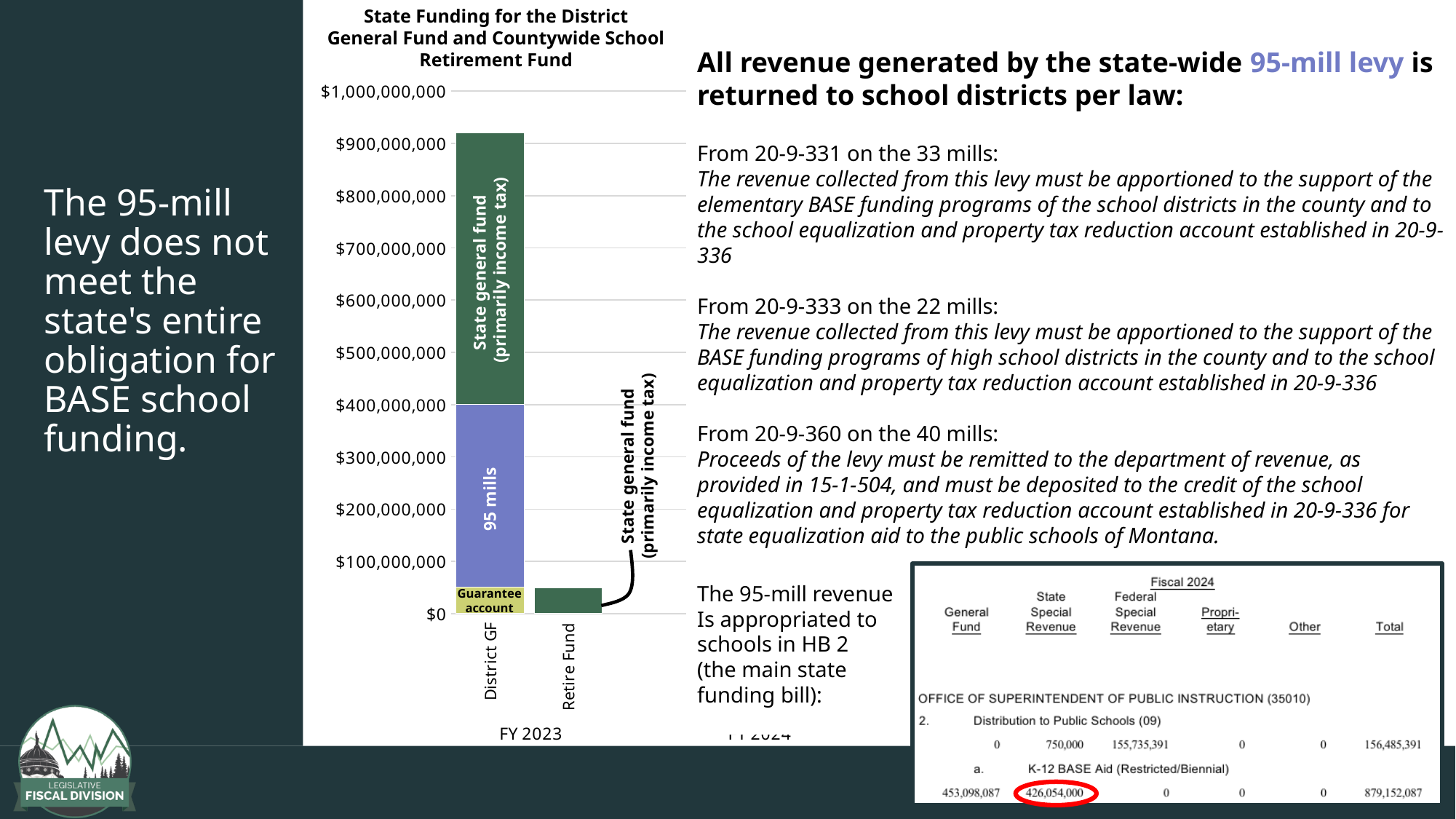
Is the Guarantee account segment in the District GF bar greater or less than $100,000,000? less Which category has the lowest total bar in the chart? Retire Fund What kind of chart is shown on the slide? bar chart What is the title of the chart? State Funding for the District General Fund and Countywide School Retirement Fund Which segment of the District GF bar is shown in purple? 95 mills What is the highest value shown on the y axis of the chart? $1,000,000,000 Which category has the taller bar, District GF or Retire Fund? District GF Is the top of the 95 mills segment in the District GF bar greater or less than $500,000,000? less How many categories are shown on the x axis of the chart? 2 Is the value of the Retire Fund bar greater or less than $100,000,000? less How many labeled segments make up the District GF bar? 3